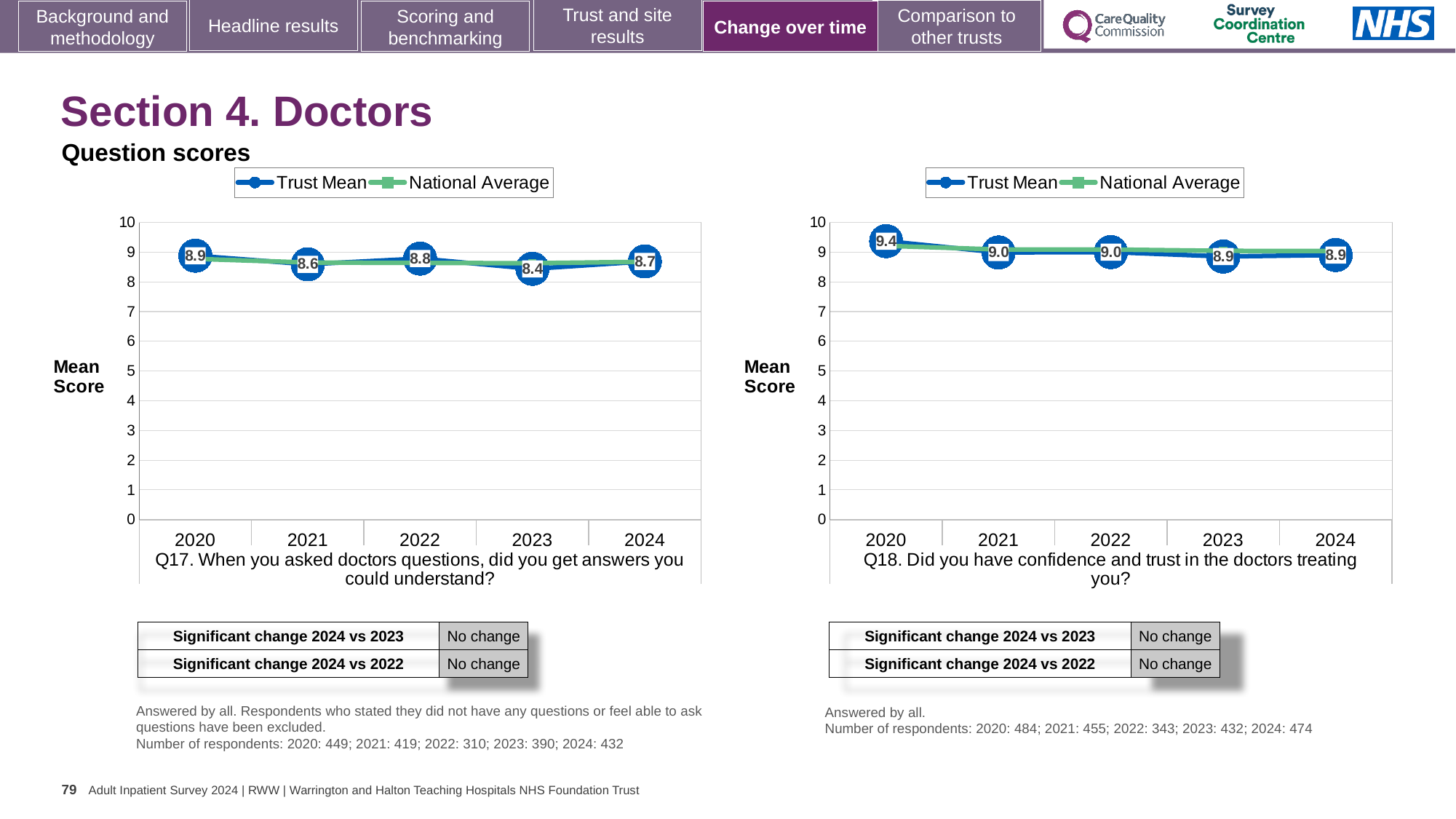
In the Q18 chart (right), what is the Trust Mean score for 2020? 9.4 What type of chart is used for Q18 (right)? line chart How many years are plotted on the x axis of the Q18 chart (right)? 5 In the Q17 chart (left), is the Trust Mean score for 2022 larger or smaller than the score for 2021? larger In the Q17 chart (left), what is the difference between the Trust Mean scores for 2020 and 2023? 0.5 In the Q18 chart (right), what is the difference between the Trust Mean scores for 2020 and 2024? 0.5 In the Q17 chart (left), what is the Trust Mean score for 2020? 8.9 In the Q18 chart (right), what is the Trust Mean score for 2024? 8.9 In the Q17 chart (left), what is the Trust Mean score for 2023? 8.4 In the Q18 chart (right), which year has the highest Trust Mean score? 2020 In the Q17 chart (left), which year has the lowest Trust Mean score? 2023 How many series does the legend of the Q17 chart (left) list? 2